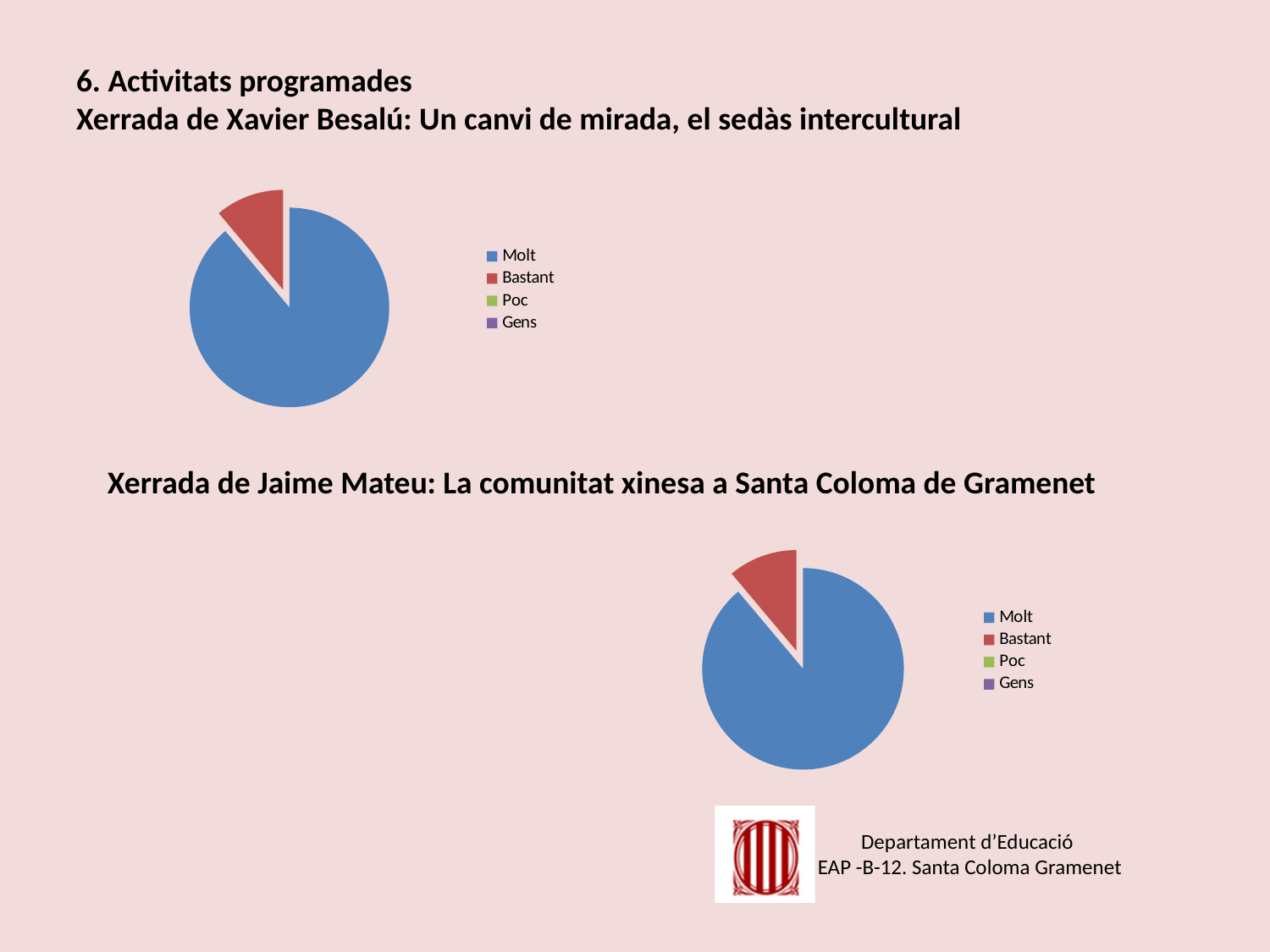
In the top chart (Xerrada de Xavier Besalú), which category has the largest slice? Molt In the top chart (Xerrada de Xavier Besalú), what colour is the Molt slice? blue In the bottom chart (Xerrada de Jaime Mateu), which category is shown in red? Bastant What kind of chart is the top chart (Xerrada de Xavier Besalú)? pie chart How many entries does the legend of the bottom chart (Xerrada de Jaime Mateu) list? 4 In the bottom chart (Xerrada de Jaime Mateu), which category has the largest slice? Molt In the bottom chart (Xerrada de Jaime Mateu), which is larger, Bastant or Molt? Molt How many categories does the legend of the top chart (Xerrada de Xavier Besalú) list? 4 In the top chart (Xerrada de Xavier Besalú), which is larger, Molt or Bastant? Molt What kind of chart is the bottom chart (Xerrada de Jaime Mateu)? pie chart